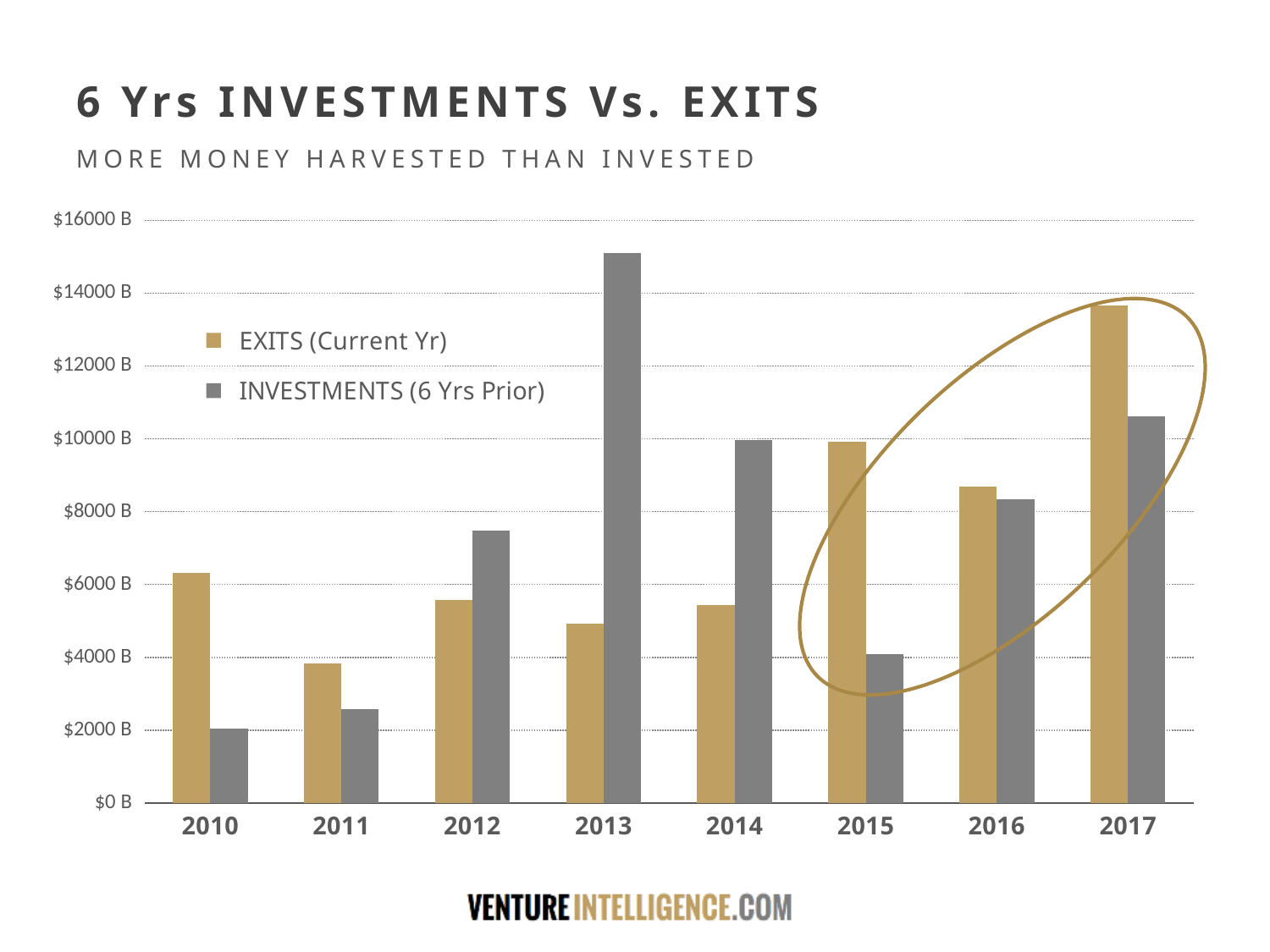
In which year is the INVESTMENTS (6 Yrs Prior) bar the highest? 2013 How many series does the legend list? 2 In which year is the EXITS (Current Yr) bar the lowest? 2011 In 2013, which is larger: EXITS (Current Yr) or INVESTMENTS (6 Yrs Prior)? INVESTMENTS (6 Yrs Prior) In which year is the EXITS (Current Yr) bar the highest? 2017 Is the value for INVESTMENTS (6 Yrs Prior) in 2010 greater or less than $4000 B? less Is the value for INVESTMENTS (6 Yrs Prior) in 2013 greater or less than $14000 B? greater How many years are shown on the x axis? 8 In 2015, which is larger: EXITS (Current Yr) or INVESTMENTS (6 Yrs Prior)? EXITS (Current Yr) Is the value for EXITS (Current Yr) in 2017 greater or less than $12000 B? greater What kind of chart is shown on the slide? Bar chart Do the INVESTMENTS (6 Yrs Prior) values rise or fall from 2010 to 2013? rise